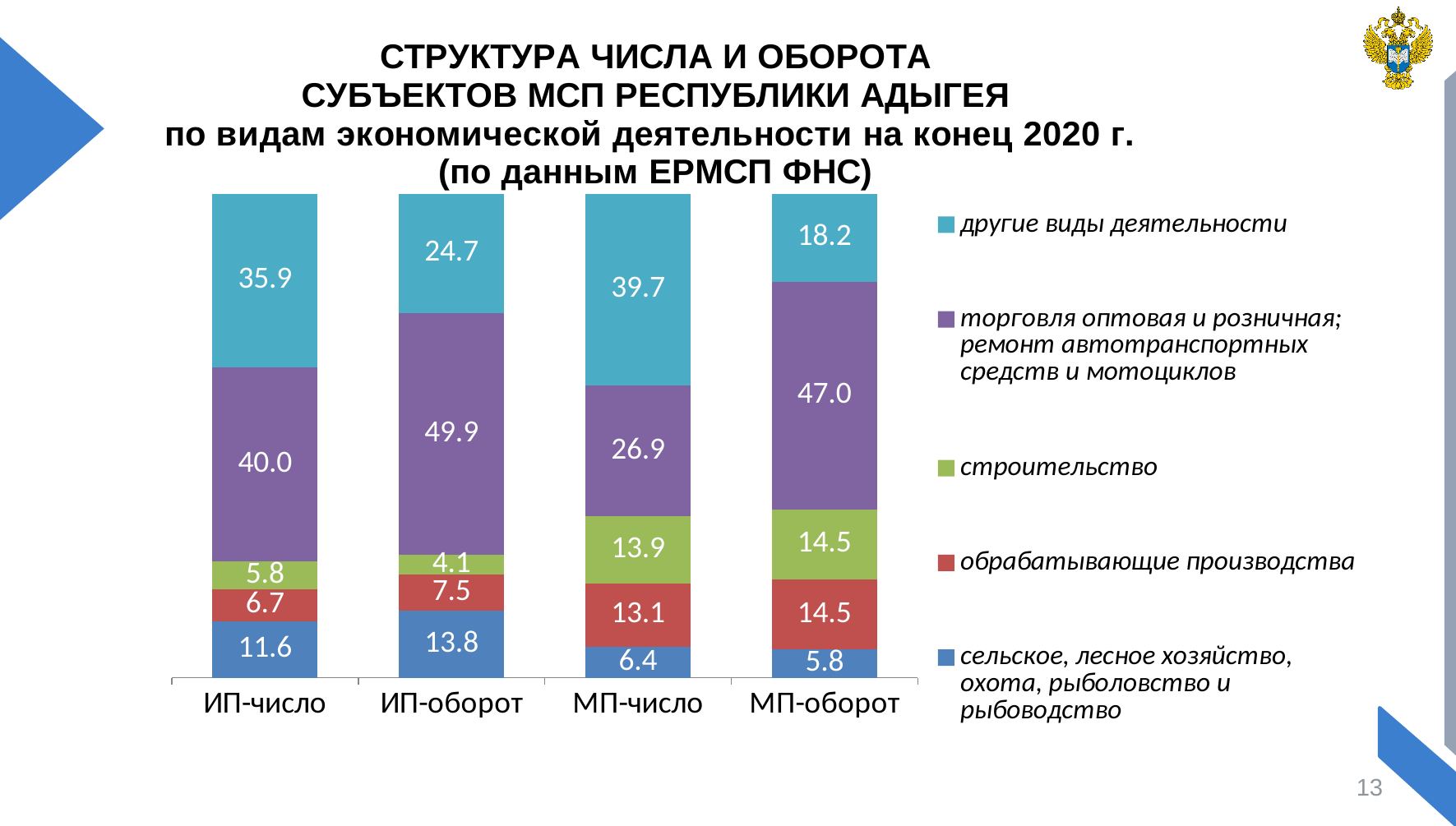
Which category has the highest value for другие виды деятельности? МП-число What is the value for строительство in the МП-оборот bar? 14.5 What is the value for другие виды деятельности in the ИП-число bar? 35.9 What is the value for торговля оптовая и розничная in the ИП-оборот bar? 49.9 How many series does the legend list? 5 What kind of chart is shown on the slide? Stacked bar chart What is the difference between the торговля оптовая и розничная values for МП-оборот and МП-число? 20.1 How many categories are shown on the x axis? 4 What is the total of the ИП-оборот stacked bar? 100.0 What is the value for сельское, лесное хозяйство, охота, рыболовство и рыбоводство in the МП-число bar? 6.4 Which is larger: the обрабатывающие производства value for ИП-число or for МП-число? МП-число Which category has the lowest value for строительство? ИП-оборот